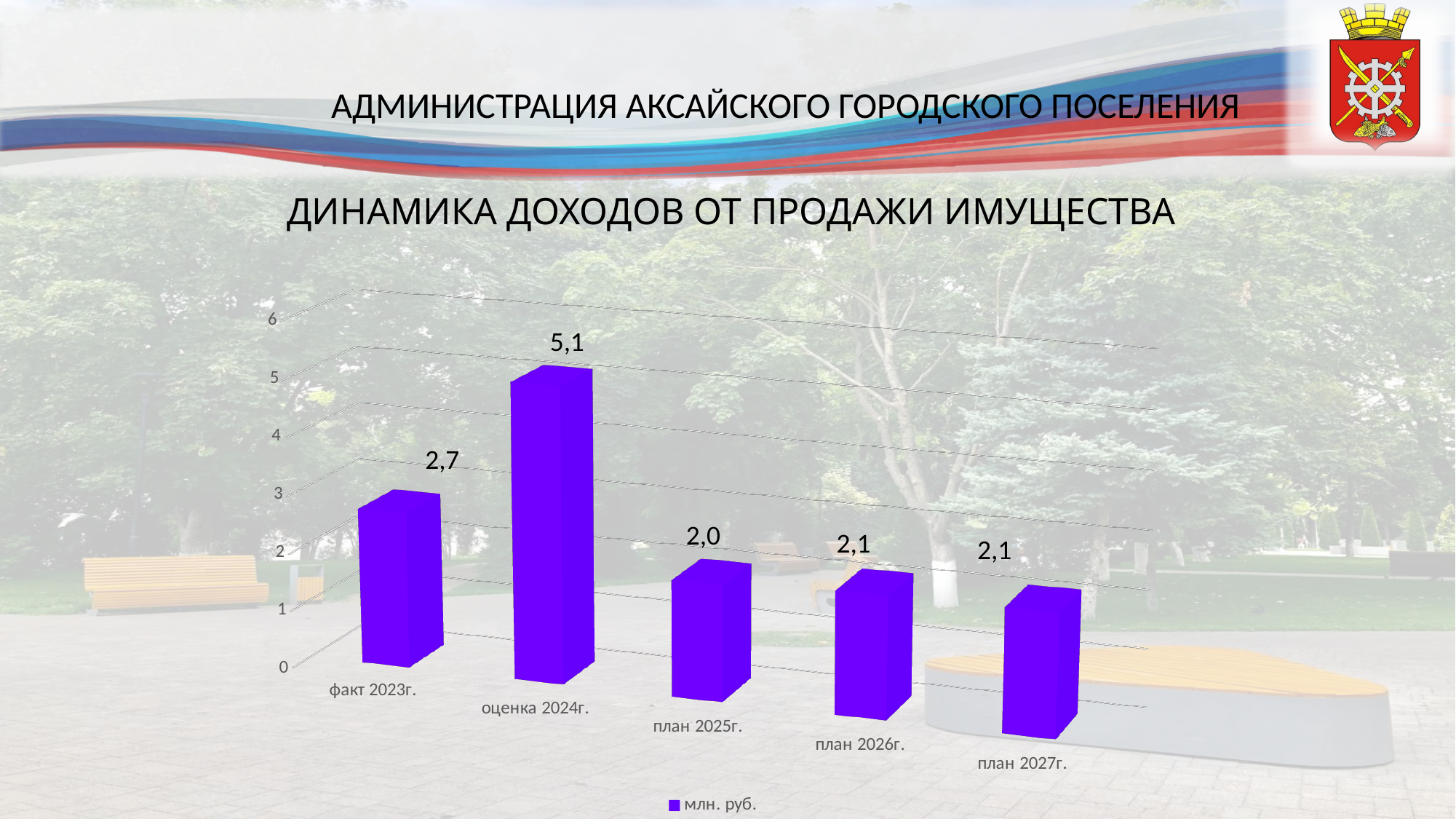
Which category has the lowest value? план 2025г. Is the value for оценка 2024г. greater or less than 4? greater What is the value for оценка 2024г.? 5,1 What is the title of the chart? ДИНАМИКА ДОХОДОВ ОТ ПРОДАЖИ ИМУЩЕСТВА What kind of chart is shown on the slide? bar chart What is the difference between the values for оценка 2024г. and факт 2023г.? 2,4 What is the value for факт 2023г.? 2,7 Which category has the highest value? оценка 2024г. How many categories are shown on the chart? 5 Which is larger, the value for факт 2023г. or the value for план 2026г.? факт 2023г. How many series does the legend list? 1 What is the value for план 2025г.? 2,0